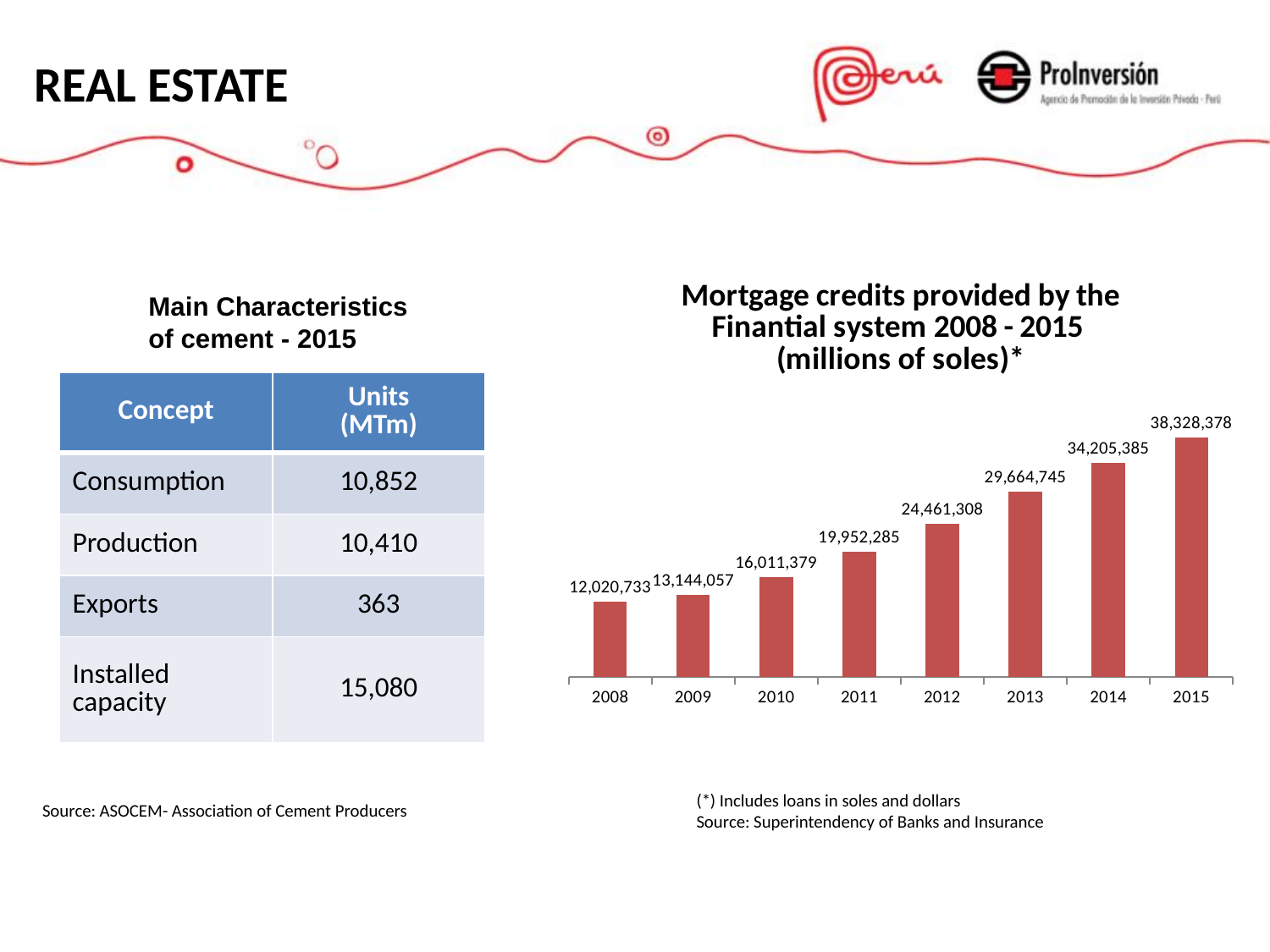
What was the value of mortgage credits in 2015? 38,328,378 Do the mortgage credit values rise or fall from 2008 to 2015? rise How many years are shown on the mortgage credits chart? 8 What type of chart is used to show mortgage credits provided by the financial system 2008-2015? bar chart Which year had a larger value of mortgage credits, 2010 or 2013? 2013 What is the difference between the mortgage credits in 2015 and 2014? 4,122,993 In what unit are the mortgage credit values expressed according to the chart title? millions of soles What was the value of mortgage credits in 2008? 12,020,733 What is the difference between the mortgage credits in 2012 and 2011? 4,509,023 Which year has the highest value of mortgage credits? 2015 Which year has the lowest value of mortgage credits? 2008 What was the value of mortgage credits in 2012? 24,461,308